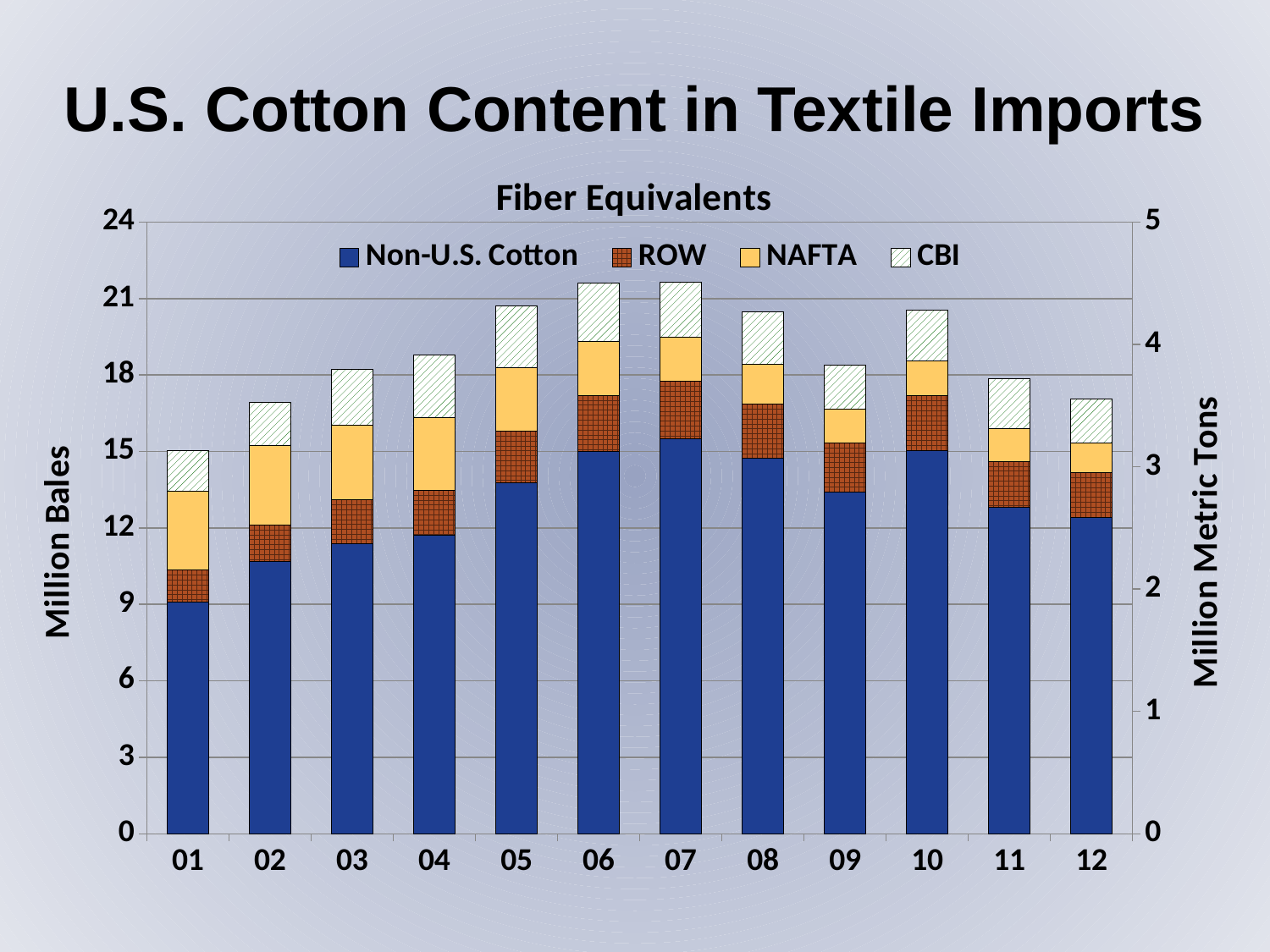
Do the total bars rise or fall from 01 to 06? rise Which year has the larger total bar, 05 or 09? 05 Is the total bar for 12 greater or less than 18 million bales? less Which year has the lowest total bar? 01 How many years (categories) are shown on the x axis? 12 Which year has the larger Non-U.S. Cotton segment, 02 or 08? 08 Which year has the smallest Non-U.S. Cotton segment? 01 How many series does the legend list? 4 What is the label on the left vertical axis? Million Bales Is the Non-U.S. Cotton segment for 05 greater or less than 12 million bales? greater Is the total bar for 06 greater or less than 21 million bales? greater What kind of chart is shown on the slide? Stacked bar chart